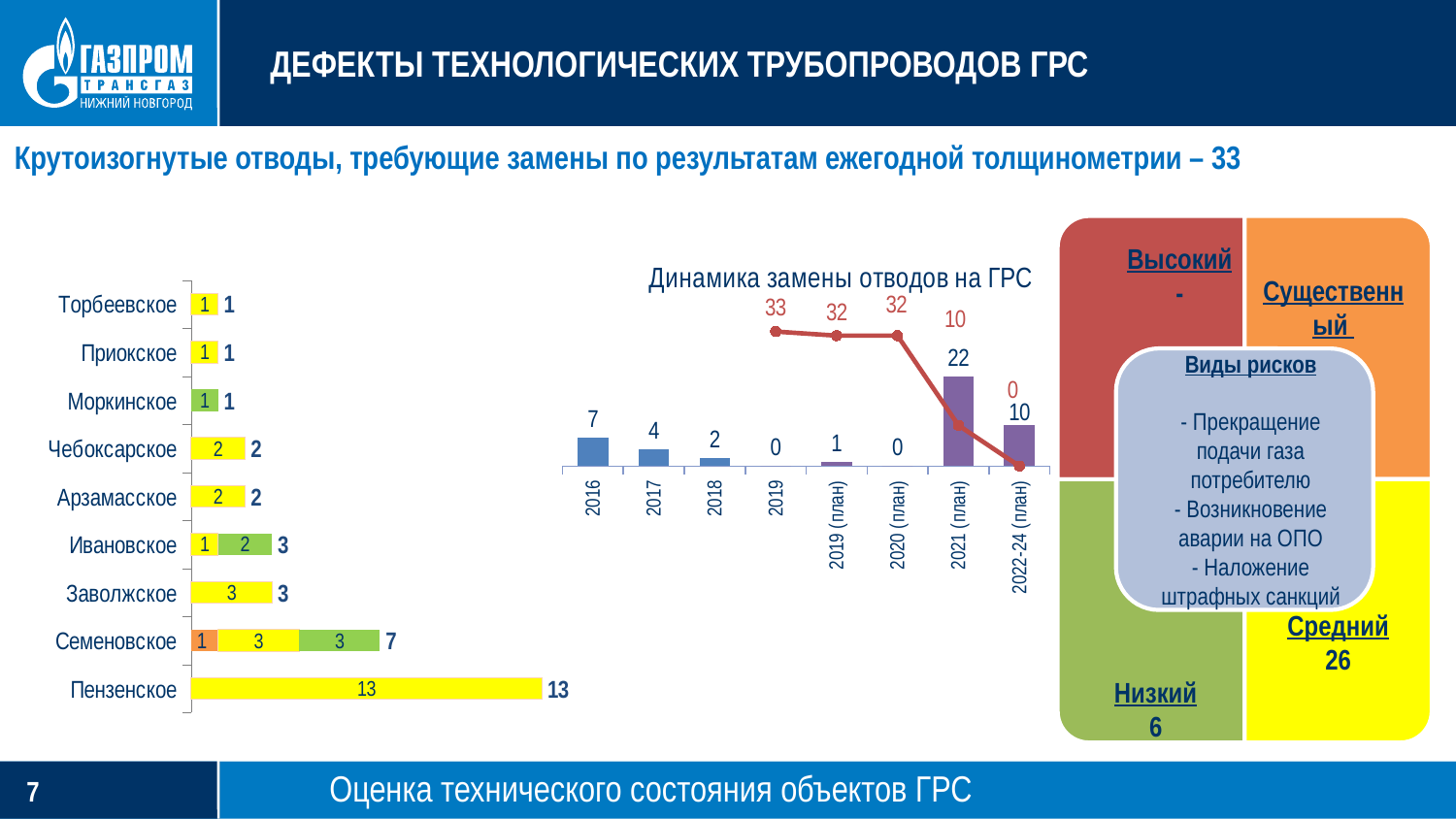
In the horizontal bar chart on the left, which is larger: the total for Ивановское or the total for Чебоксарское? Ивановское In the horizontal bar chart on the left, what is the total value for Пензенское? 13 In the chart 'Динамика замены отводов на ГРС', which year has the highest bar value? 2021 (план) In the chart 'Динамика замены отводов на ГРС', what is the difference between the bar values for 2016 and 2017? 3 In the horizontal bar chart on the left, how many categories are listed? 9 In the chart 'Динамика замены отводов на ГРС', what is the bar value for 2021 (план)? 22 In the horizontal bar chart on the left, which category has the highest total? Пензенское In the horizontal bar chart on the left, what is the total value for Семеновское? 7 In the chart 'Динамика замены отводов на ГРС', how many year categories are shown on the x axis? 8 In the chart 'Динамика замены отводов на ГРС', what is the bar value for 2016? 7